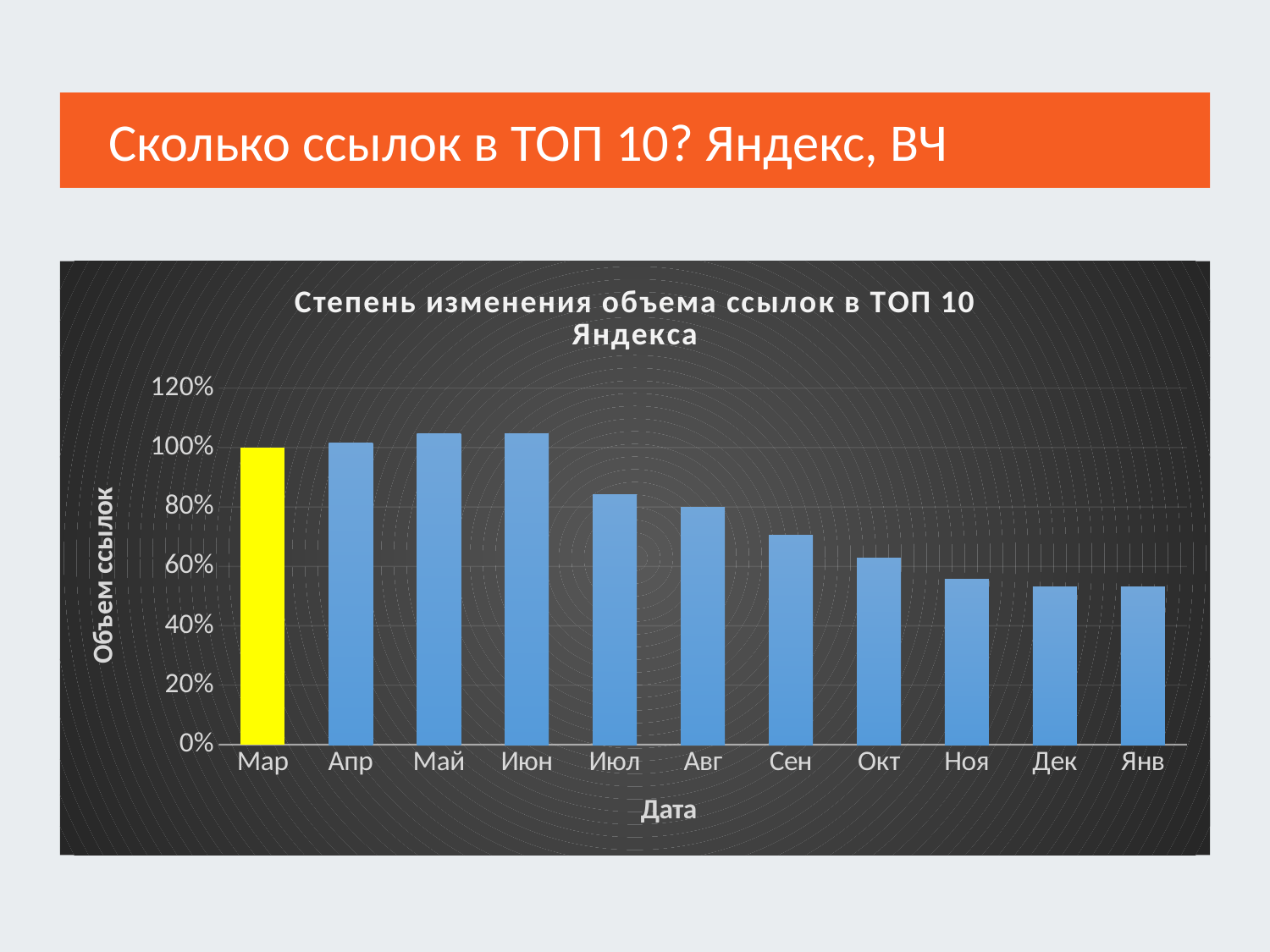
What kind of chart is shown on the slide? bar chart Is the value for Ноя greater or less than 60%? less Do the values generally rise or fall from Июн to Янв? fall What is the title of the chart? Степень изменения объема ссылок в ТОП 10 Яндекса How many months (categories) are shown on the x axis of the chart? 11 Is the value for Янв greater or less than 60%? less Is the value for Сен greater or less than 80%? less Which is larger, the value for Окт or the value for Авг? Авг Which month's bar is highlighted in yellow? Мар What is the value for Мар? 100% Which is larger, the value for Апр or the value for Июл? Апр